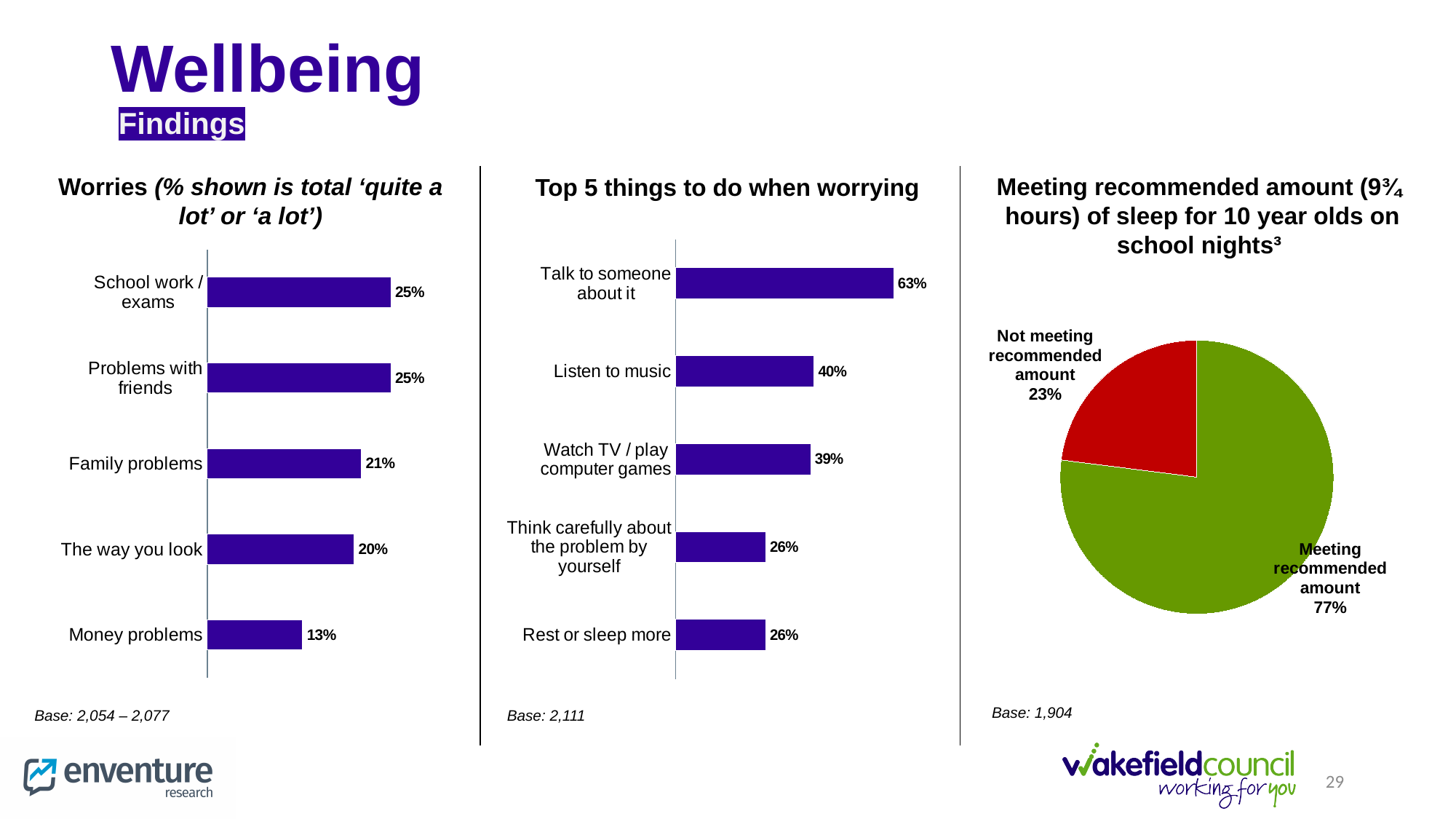
In the 'Top 5 things to do when worrying' chart, what percentage is shown for 'Listen to music'? 40% In the 'Worries' chart, what is the difference between 'The way you look' and 'Money problems'? 7% In the pie chart about meeting the recommended amount of sleep, what share is 'Not meeting recommended amount'? 23% In the 'Worries' chart, how many categories are shown? 5 In the 'Worries' chart, what percentage is shown for Family problems? 21% In the 'Top 5 things to do when worrying' chart, which category has the highest value? Talk to someone about it What is the base shown under the pie chart about meeting the recommended amount of sleep? Base: 1,904 In the 'Worries' chart, which category has the lowest value? Money problems In the 'Top 5 things to do when worrying' chart, which is larger: 'Listen to music' or 'Think carefully about the problem by yourself'? Listen to music In the 'Top 5 things to do when worrying' chart, what is the difference between 'Talk to someone about it' and 'Rest or sleep more'? 37% In the pie chart about meeting the recommended amount of sleep, which slice is larger? Meeting recommended amount What kind of chart is the 'Top 5 things to do when worrying' chart? Bar chart